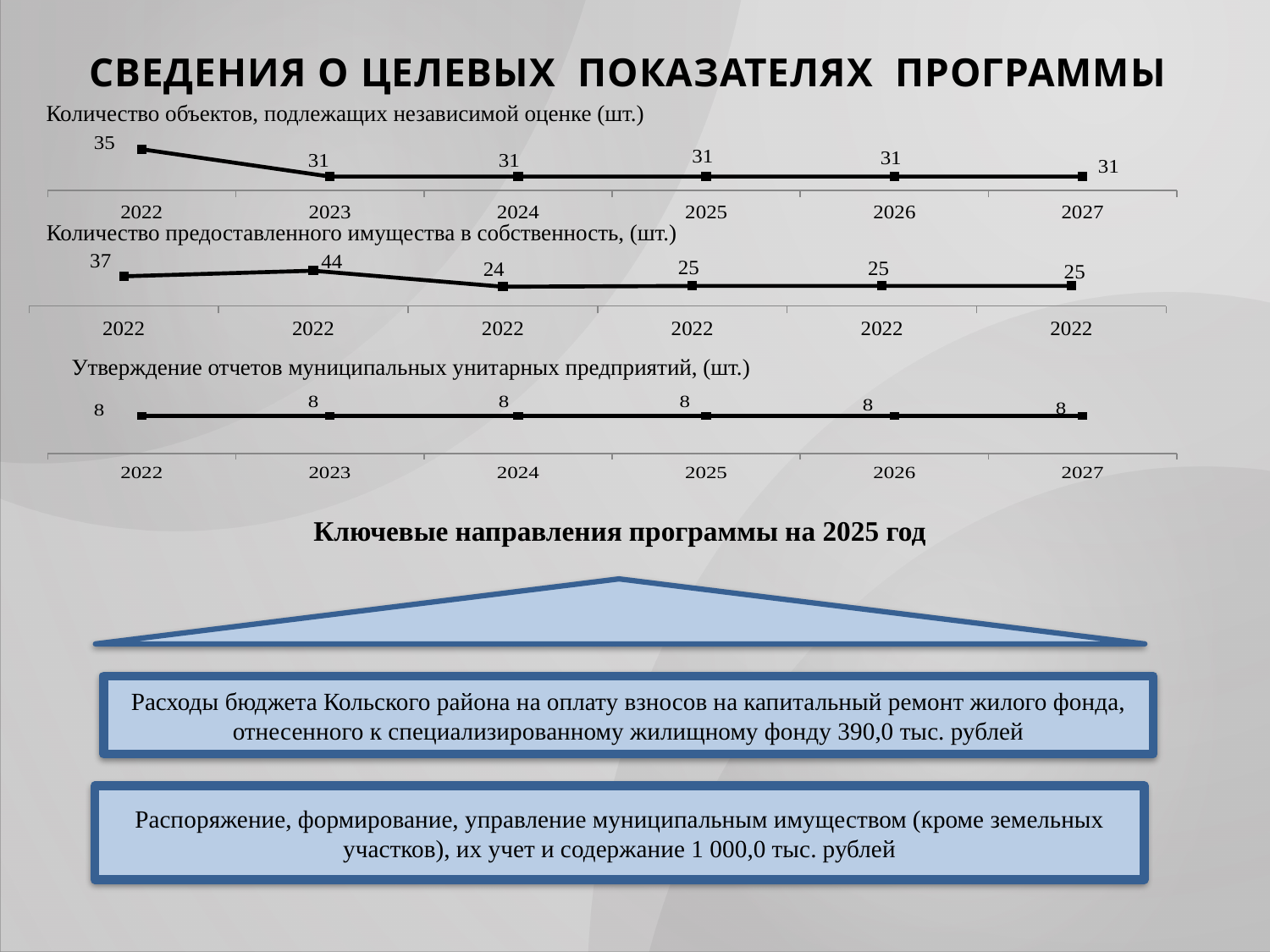
In the bottom chart 'Утверждение отчетов муниципальных унитарных предприятий, (шт.)', what is the value for 2025? 8 In the middle chart 'Количество предоставленного имущества в собственность, (шт.)', what is the value of the second data point? 44 In the top chart 'Количество объектов, подлежащих независимой оценке (шт.)', what is the difference between the 2022 value and the 2023 value? 4 In the top chart 'Количество объектов, подлежащих независимой оценке (шт.)', how many data points are plotted? 6 In the top chart 'Количество объектов, подлежащих независимой оценке (шт.)', what is the value for 2027? 31 In the middle chart 'Количество предоставленного имущества в собственность, (шт.)', what is the difference between the highest value (44) and the lowest value (24)? 20 In the top chart 'Количество объектов, подлежащих независимой оценке (шт.)', which year has the highest value? 2022 In the middle chart 'Количество предоставленного имущества в собственность, (шт.)', which is larger: the first data point or the third data point? the first data point (37) In the top chart 'Количество объектов, подлежащих независимой оценке (шт.)', what is the value for 2022? 35 In the bottom chart 'Утверждение отчетов муниципальных унитарных предприятий, (шт.)', do the values rise, fall, or stay flat from 2022 to 2027? stay flat In the middle chart 'Количество предоставленного имущества в собственность, (шт.)', what is the lowest value shown? 24 What type of chart is used for the three charts on the slide? line chart